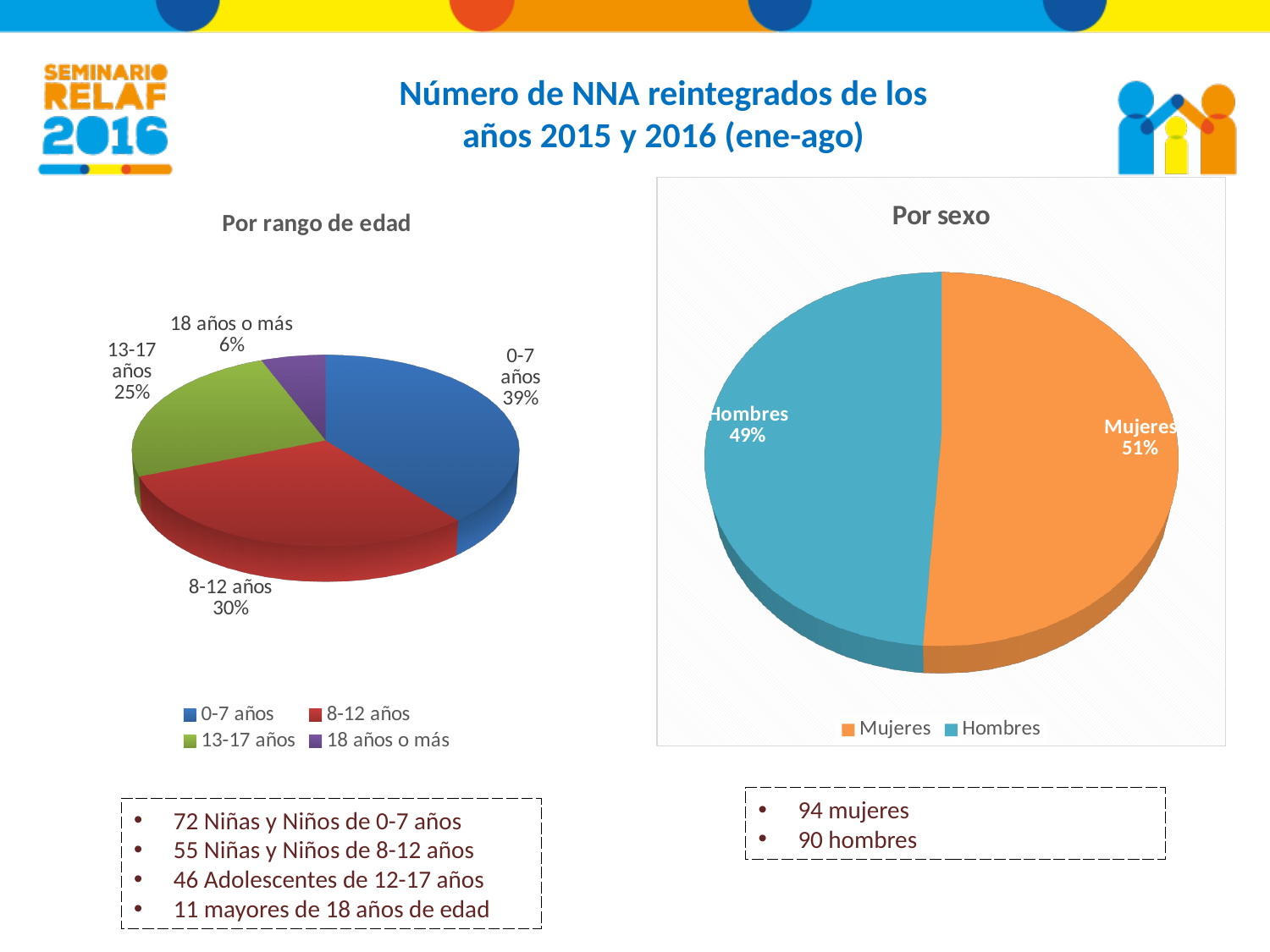
In the 'Por rango de edad' chart, what is the difference in percentage points between the 0-7 años and 13-17 años slices? 14 In the 'Por rango de edad' chart, which age range has the largest slice? 0-7 años In the 'Por sexo' chart, what share does the Hombres slice have? 49% In the 'Por rango de edad' chart, what colour is the 8-12 años slice? Red In the 'Por rango de edad' chart, which age range has the smallest slice? 18 años o más In the 'Por rango de edad' chart, what share does the 13-17 años slice have? 25% What kind of chart is the 'Por sexo' chart? Pie chart In the 'Por rango de edad' chart, what share does the 0-7 años slice have? 39% In the 'Por rango de edad' chart, how many slices does the pie have? 4 In the 'Por sexo' chart, how many entries does the legend list? 2